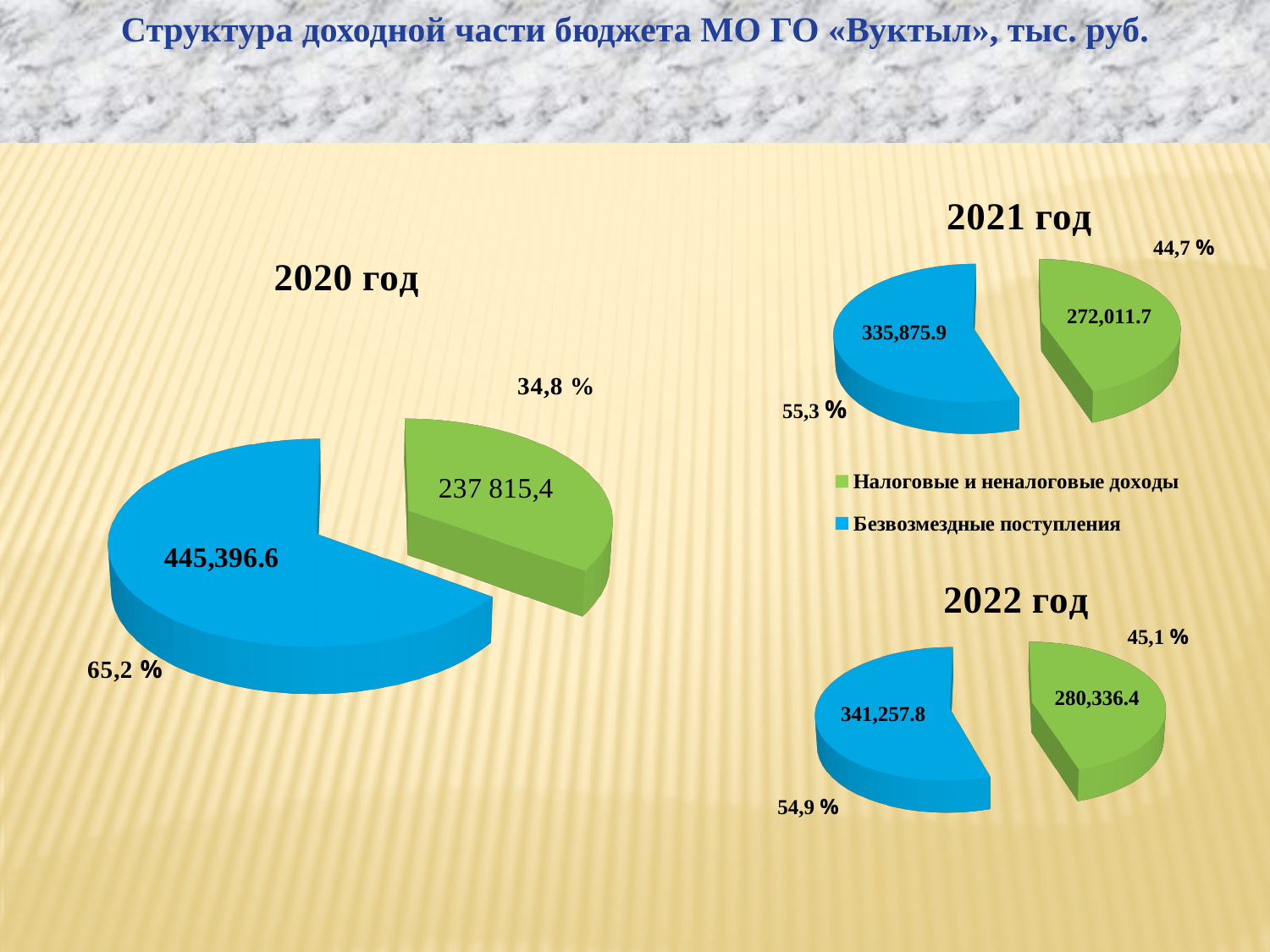
In the 2022 год chart, which category is the smallest? Налоговые и неналоговые доходы In the 2021 год chart, what is the value for Налоговые и неналоговые доходы? 272,011.7 In the 2022 год chart, what is the value for Безвозмездные поступления? 341,257.8 What kind of chart is the 2020 год chart? Pie chart In the 2022 год chart, what share of the pie does Налоговые и неналоговые доходы take? 45,1 % In the 2022 год chart, which is larger: Налоговые и неналоговые доходы or Безвозмездные поступления? Безвозмездные поступления In the 2021 год chart, which category is the largest? Безвозмездные поступления In the 2020 год chart, what share of the pie does Безвозмездные поступления take? 65,2 % In the 2020 год chart, what is the value for Налоговые и неналоговые доходы? 237 815,4 In the 2020 год chart, what is the value for Безвозмездные поступления? 445,396.6 How many entries does the legend list? 2 In the 2021 год chart, what is the difference between Безвозмездные поступления and Налоговые и неналоговые доходы? 63,864.2